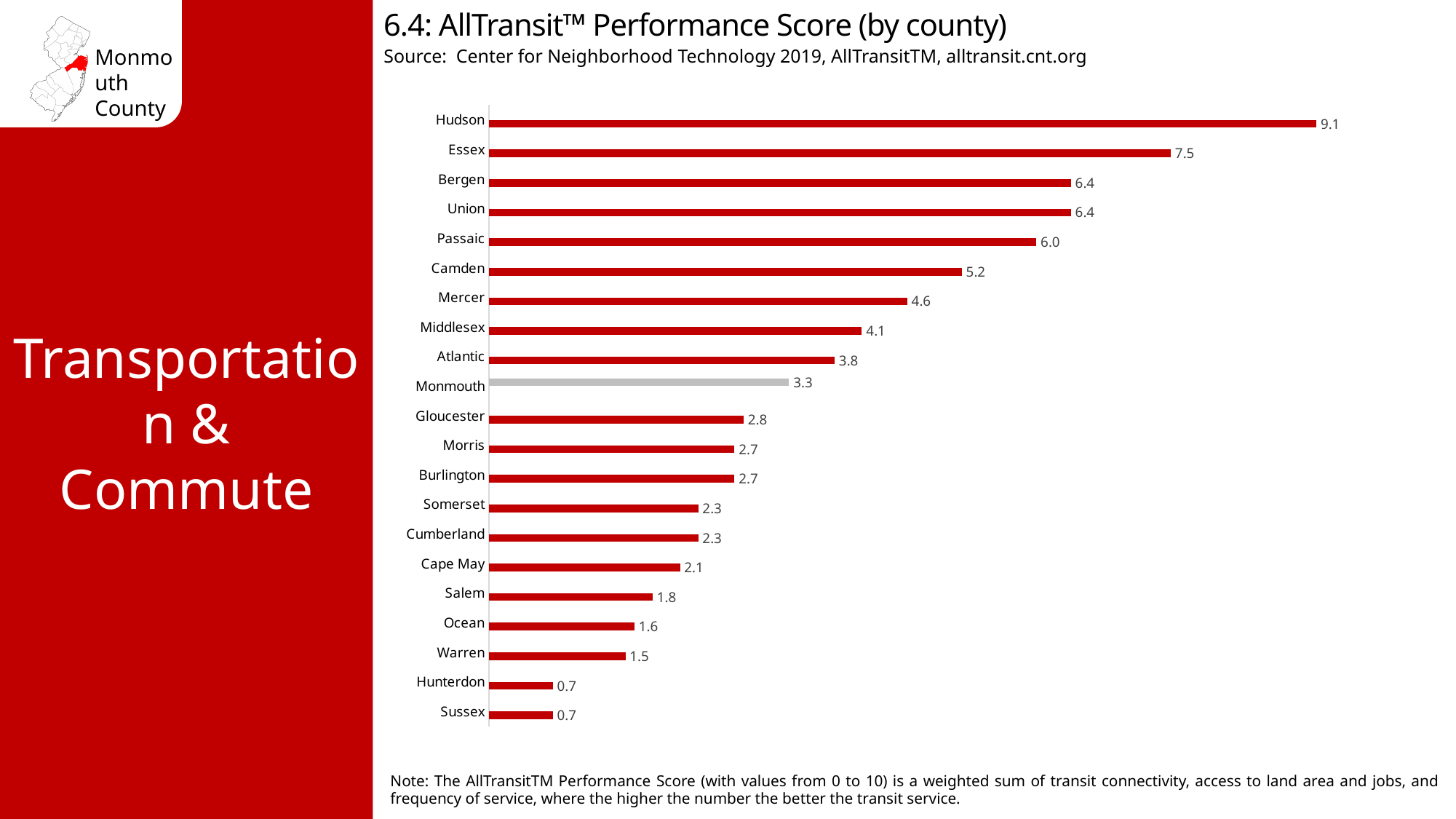
What is the AllTransit Performance Score for Monmouth? 3.3 What is the difference between the scores for Hudson and Essex? 1.6 How many counties are shown in the chart? 21 What is the difference between the scores for Monmouth and Ocean? 1.7 Which county has the highest AllTransit Performance Score? Hudson What is the title of the chart? 6.4: AllTransit™ Performance Score (by county) Which has a higher score, Mercer or Middlesex? Mercer What is the AllTransit Performance Score for Hudson? 9.1 Which has a higher score, Atlantic or Gloucester? Atlantic Which county's bar is shown in grey rather than red? Monmouth What is the AllTransit Performance Score for Camden? 5.2 What kind of chart is shown on the slide? Bar chart